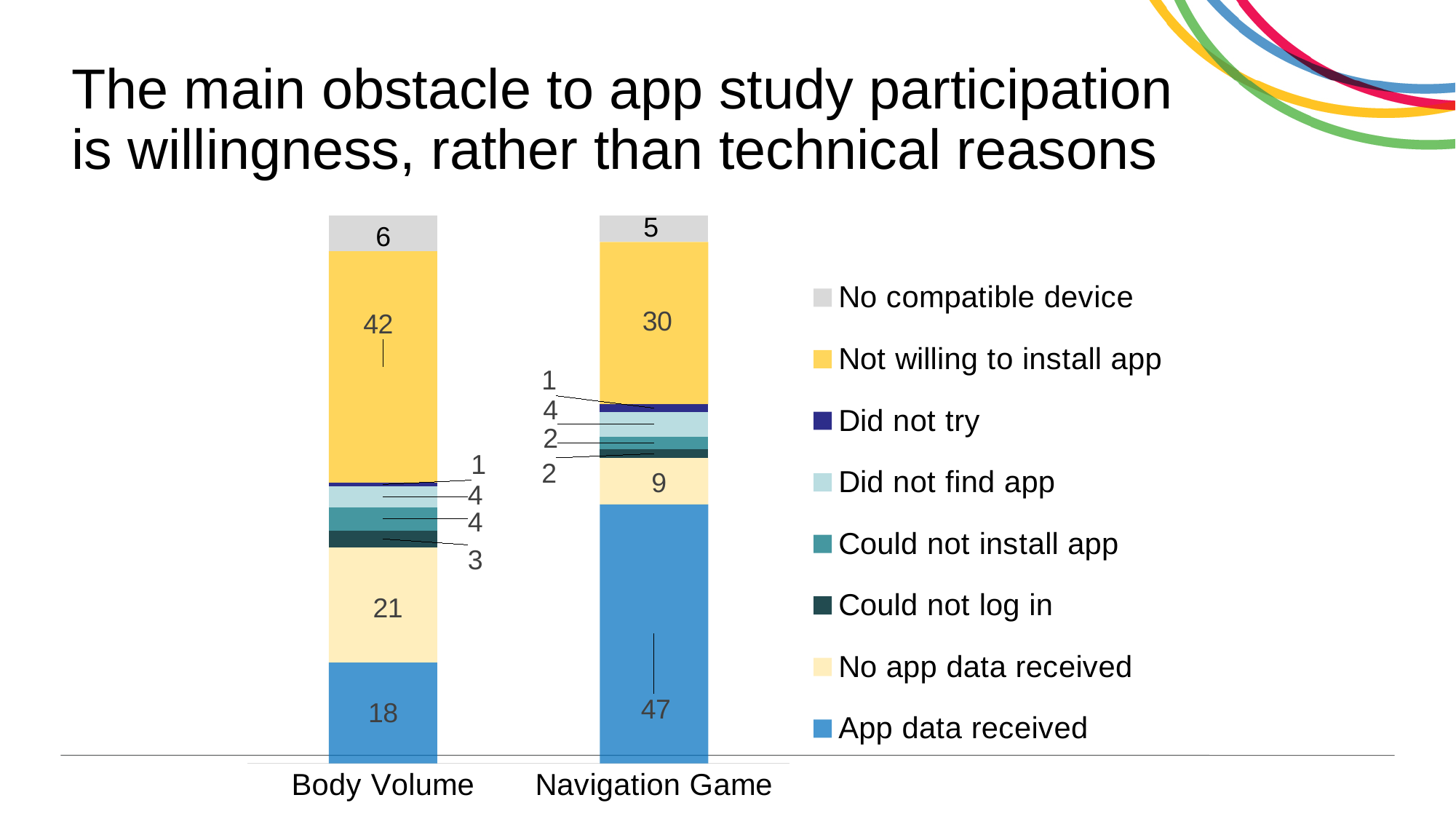
Which segment is the largest in the Navigation Game bar? App data received Which segment is the largest in the Body Volume bar? Not willing to install app How many categories are shown on the x axis? 2 Which is larger: 'Not willing to install app' for Body Volume or for Navigation Game? Body Volume What is the value for 'No compatible device' in the Navigation Game bar? 5 What is the total of the Navigation Game stacked bar? 100 What is the value for 'Not willing to install app' in the Body Volume bar? 42 What is the value for 'No app data received' in the Body Volume bar? 21 How many series does the legend list? 8 What kind of chart is shown on the slide? Stacked bar chart What is the value for 'App data received' in the Navigation Game bar? 47 What is the difference between the 'App data received' values for Navigation Game and Body Volume? 29